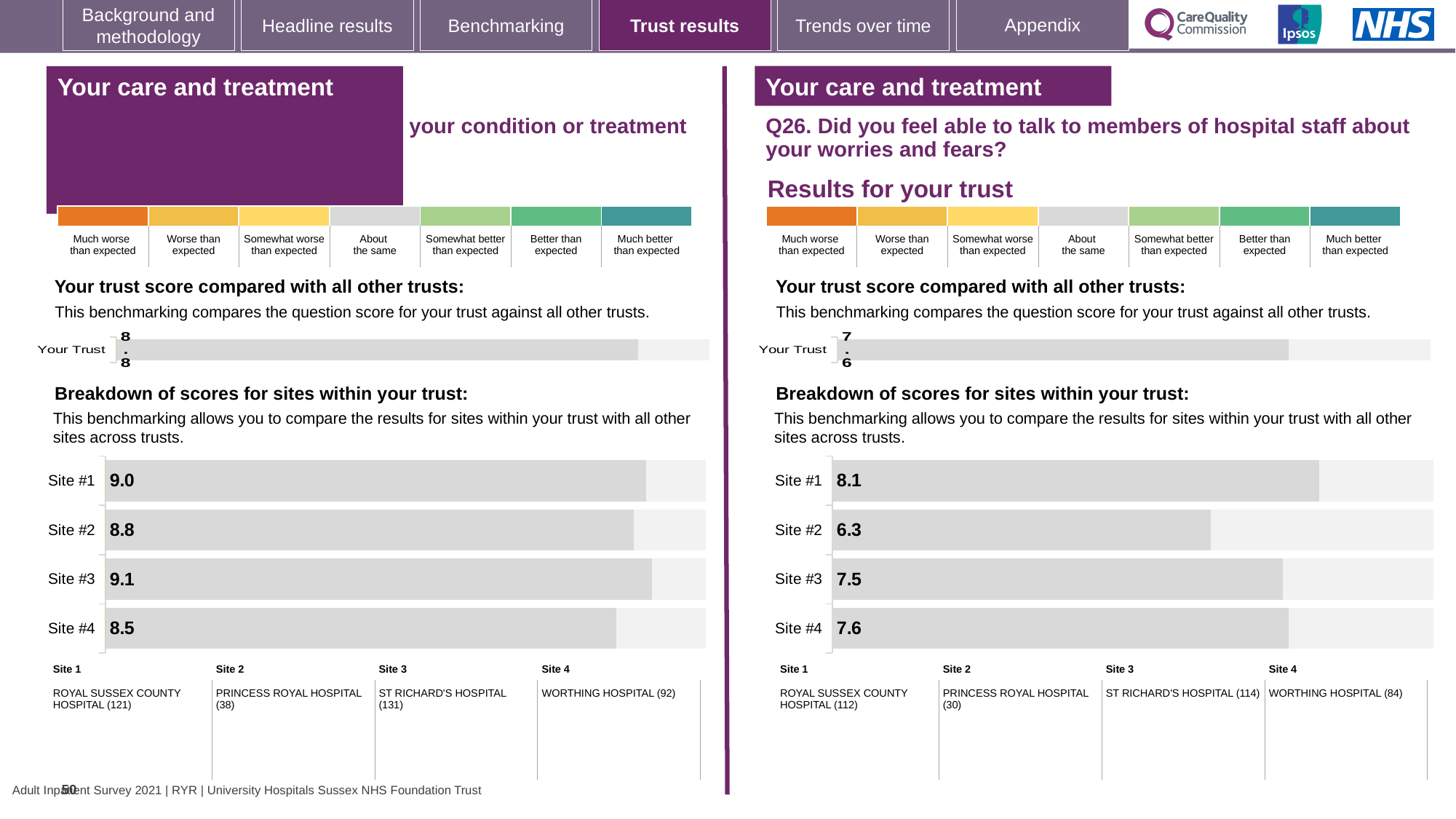
On the right-hand chart (Q26), what is the 'Your Trust' score shown in the trust comparison bar? 7.6 On the right-hand chart (Q26), which site has the lowest score? Site #2 On the right-hand chart (Q26), which has the higher score, Site #3 or Site #4? Site #4 On the left-hand chart, what is the score for Site #4? 8.5 On the right-hand chart (Q26), what is the difference between the scores for Site #1 and Site #2? 1.8 On the right-hand chart (Q26), what is the score for Site #1? 8.1 How many sites are shown in the site breakdown chart on the left-hand side of the slide? 4 On the left-hand chart, what is the score for Site #3? 9.1 On the left-hand chart, which site has the highest score? Site #3 On the right-hand chart (Q26), what is the score for Site #2? 6.3 On the left-hand chart, what is the difference between the scores for Site #3 and Site #4? 0.6 What kind of chart is used for the breakdown of scores for sites on the right-hand side of the slide? Bar chart